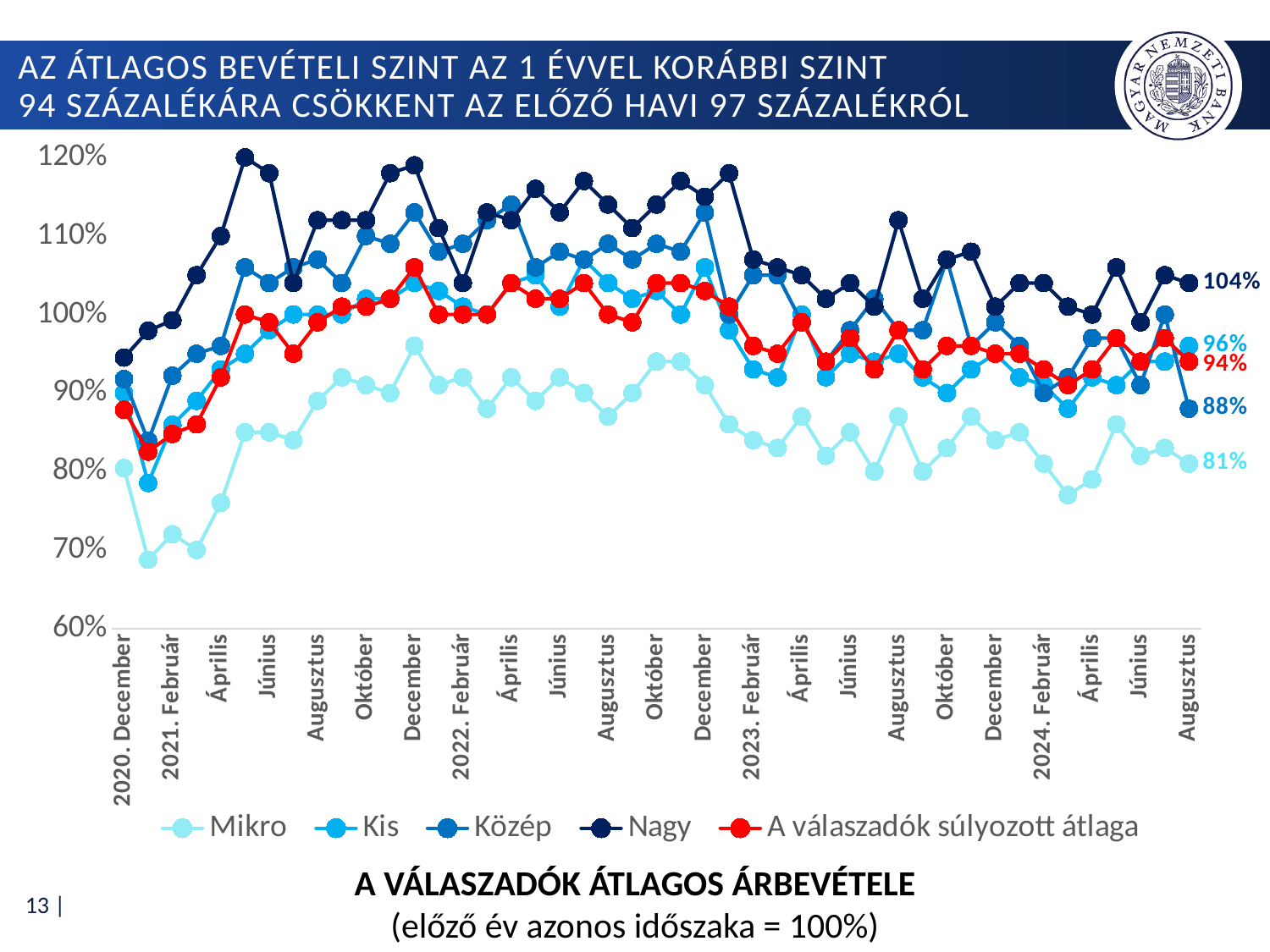
What is the value of the Mikro series at the last point (2024 Augusztus)? 81% Is the value of the Nagy series at 2021 Június greater or less than 110%? greater What is the value of the Nagy series at the last point (2024 Augusztus)? 104% What is the value of the Közép series at the last point (2024 Augusztus)? 88% How many series does the legend list? 5 What is the value of the Kis series at the last point (2024 Augusztus)? 96% At the last point (2024 Augusztus), which is larger: the Kis value or the Közép value? Kis At the last point (2024 Augusztus), what is the difference between the Nagy value and the Mikro value? 23 percentage points Which series has the lowest value at the last point (2024 Augusztus)? Mikro Which series has the highest value at the last point (2024 Augusztus)? Nagy What kind of chart is shown on the slide? Line chart What is the value of 'A válaszadók súlyozott átlaga' at the last point (2024 Augusztus)? 94%